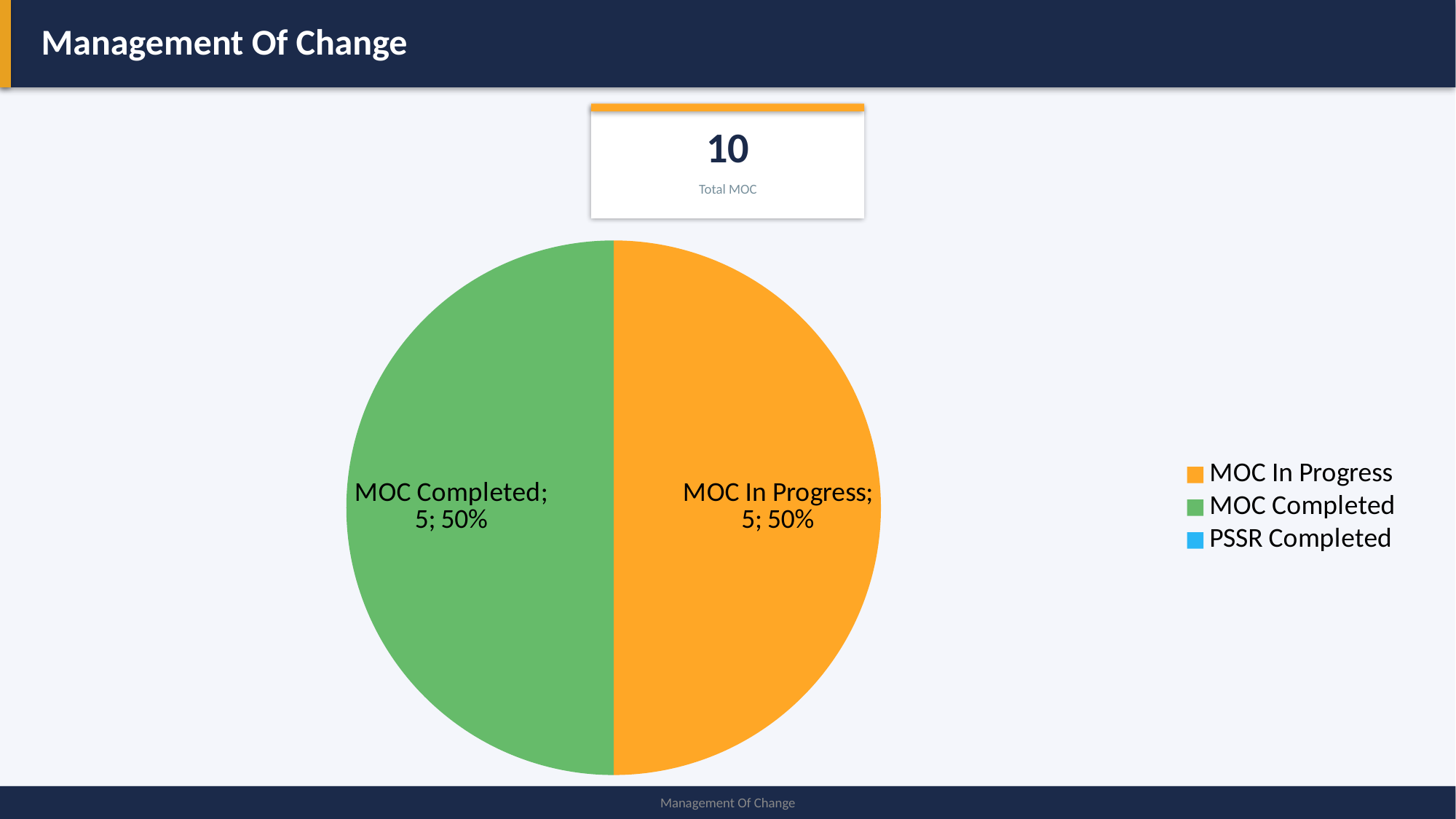
What share of the pie does MOC Completed represent? 50% What is the value for MOC Completed in the pie chart? 5 What type of chart is shown on the slide? pie chart Which legend entry has no visible slice in the pie chart? PSSR Completed What colour is the MOC In Progress slice? orange How many slices are visible in the pie chart? 2 What is the difference between the values for MOC In Progress and MOC Completed? 0 What is the Total MOC shown on the slide? 10 Is the value for MOC Completed larger than, smaller than, or equal to the value for MOC In Progress? equal What is the value for MOC In Progress in the pie chart? 5 How many entries does the legend list? 3 What share of the pie does MOC In Progress represent? 50%